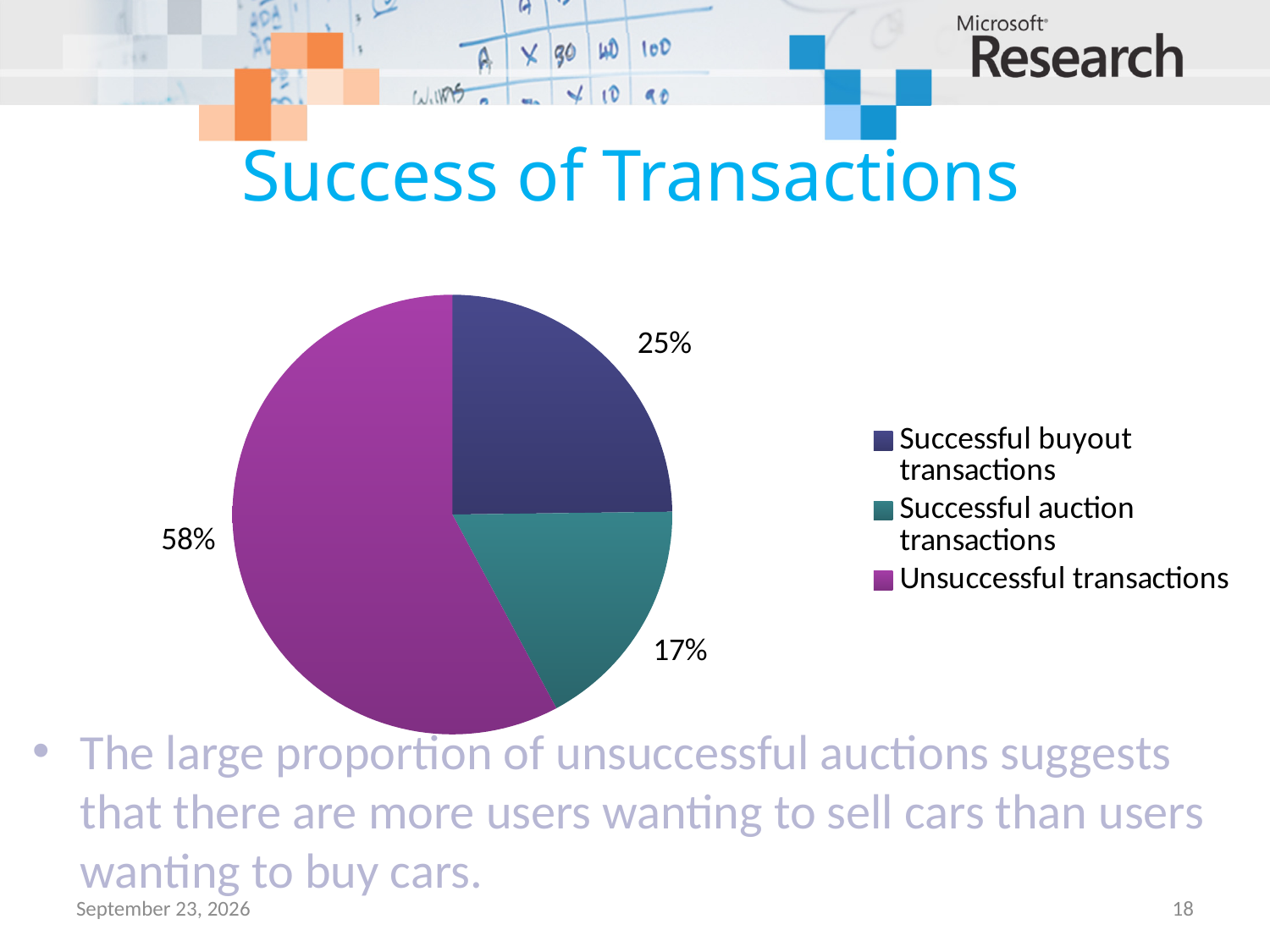
Which is larger: Successful buyout transactions or Successful auction transactions? Successful buyout transactions What colour is the Unsuccessful transactions slice? purple What is the difference in percentage points between Unsuccessful transactions and Successful buyout transactions? 33 What share of the pie is Successful buyout transactions? 25% What share of the pie is Successful auction transactions? 17% What kind of chart is shown on the slide? pie chart Which category has the smallest slice of the pie? Successful auction transactions What is the title of the slide containing the chart? Success of Transactions How many slices does the pie chart have? 3 What is the difference in percentage points between Successful buyout transactions and Successful auction transactions? 8 What share of the pie is Unsuccessful transactions? 58% Which category has the largest slice of the pie? Unsuccessful transactions